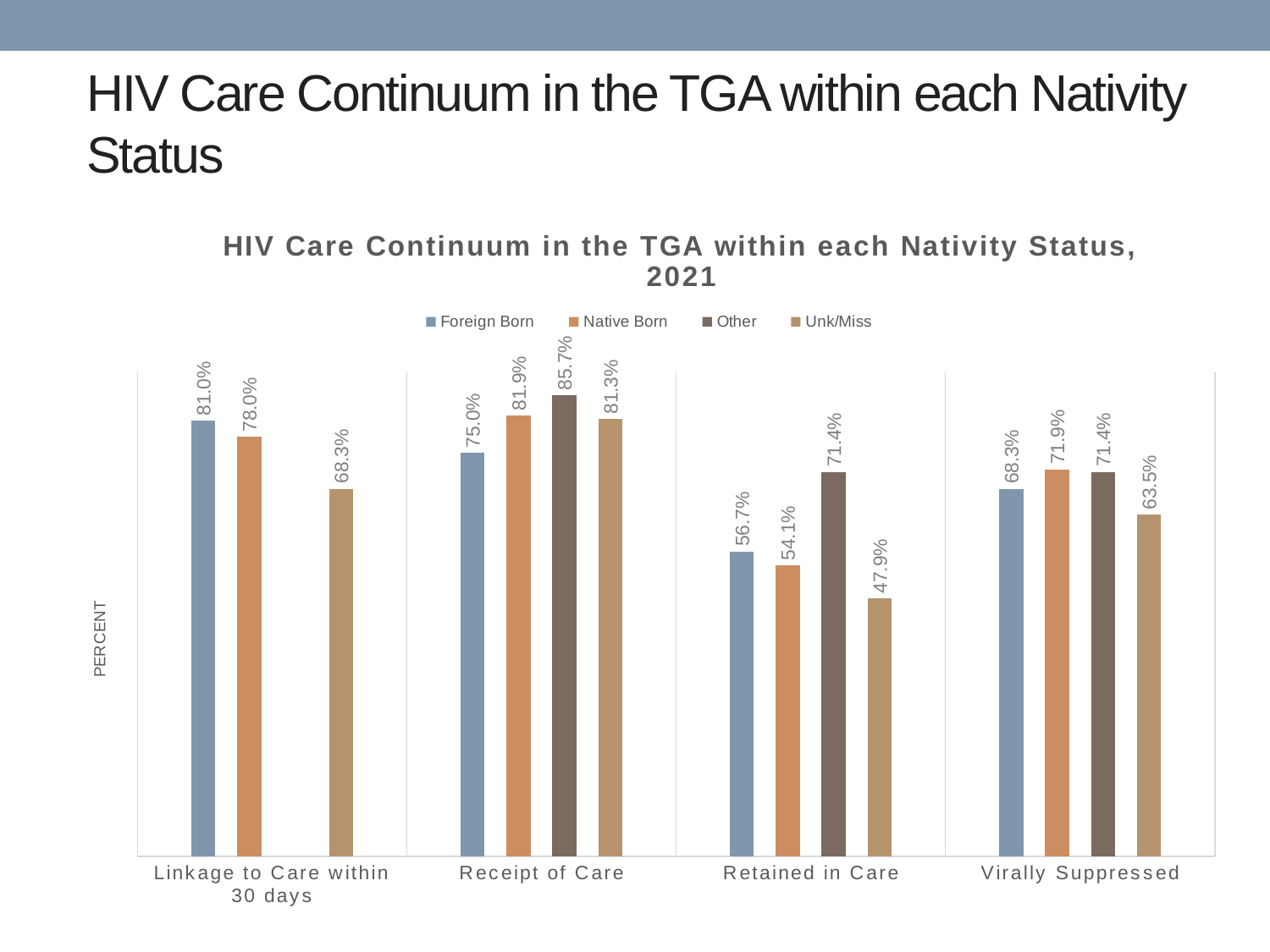
Which is larger for Virally Suppressed: Foreign Born or Unk/Miss? Foreign Born How many categories are shown on the x axis? 4 How many series does the legend list? 4 What kind of chart is shown on the slide? Bar chart Which series has the highest value for Receipt of Care? Other What is the difference between the Foreign Born and Native Born values for Retained in Care? 2.6% What is the Native Born value for Virally Suppressed? 71.9% What is the Other value for Receipt of Care? 85.7% Which series has the lowest value for Retained in Care? Unk/Miss What is the Unk/Miss value for Retained in Care? 47.9% What is the title of the chart? HIV Care Continuum in the TGA within each Nativity Status, 2021 What is the Foreign Born value for Linkage to Care within 30 days? 81.0%